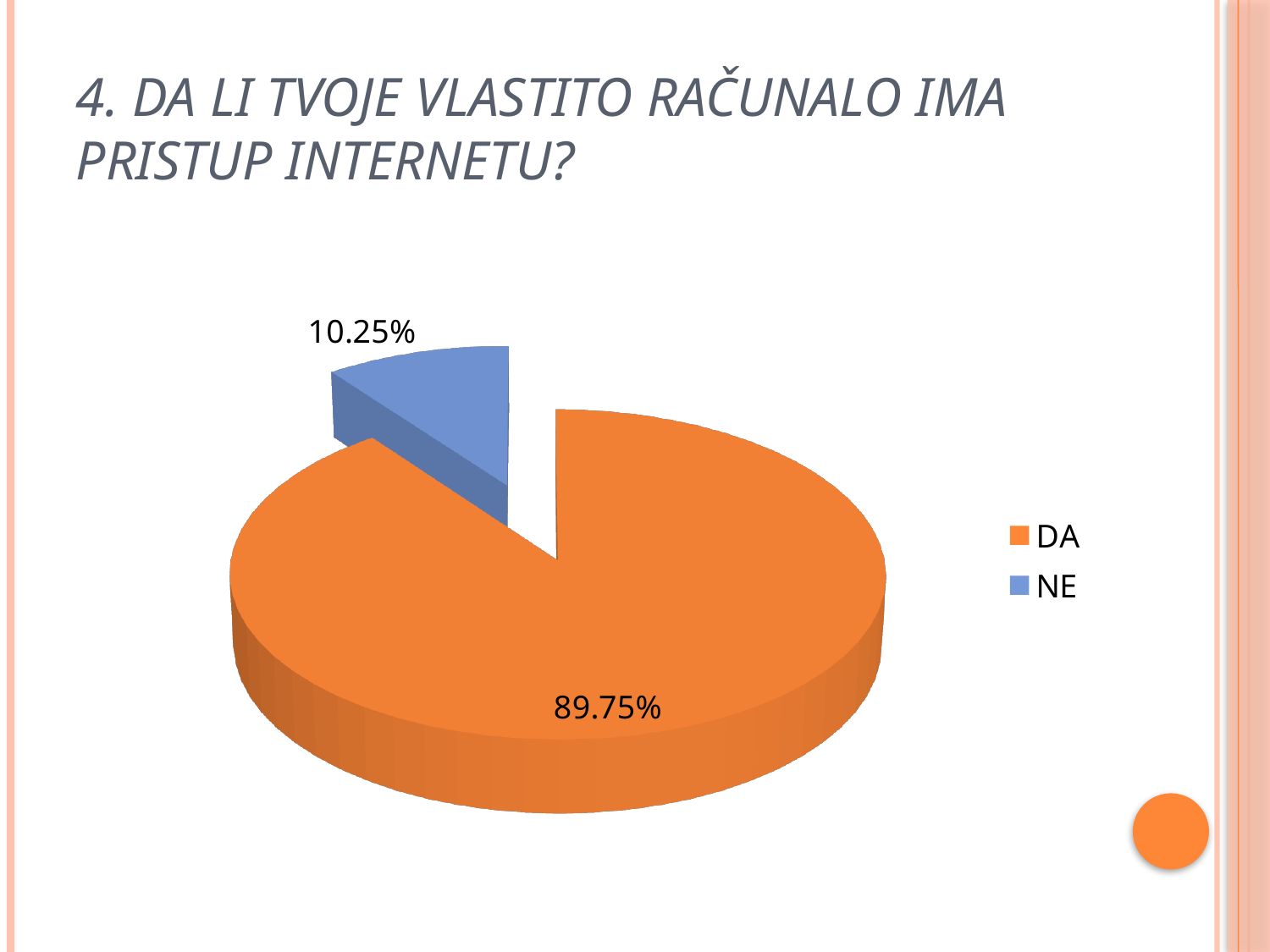
What colour is the NE slice? blue Which category has the largest slice of the pie? DA What is the total of the two slice percentages shown? 100% Which is larger, the DA slice or the NE slice? DA Which category has the smallest slice of the pie? NE How many slices does the pie chart have? 2 What colour is the DA slice? orange How many entries does the legend list? 2 What kind of chart is shown on the slide? pie chart What share of the pie does the NE slice represent? 10.25% What is the difference between the DA and NE shares? 79.50% What share of the pie does the DA slice represent? 89.75%